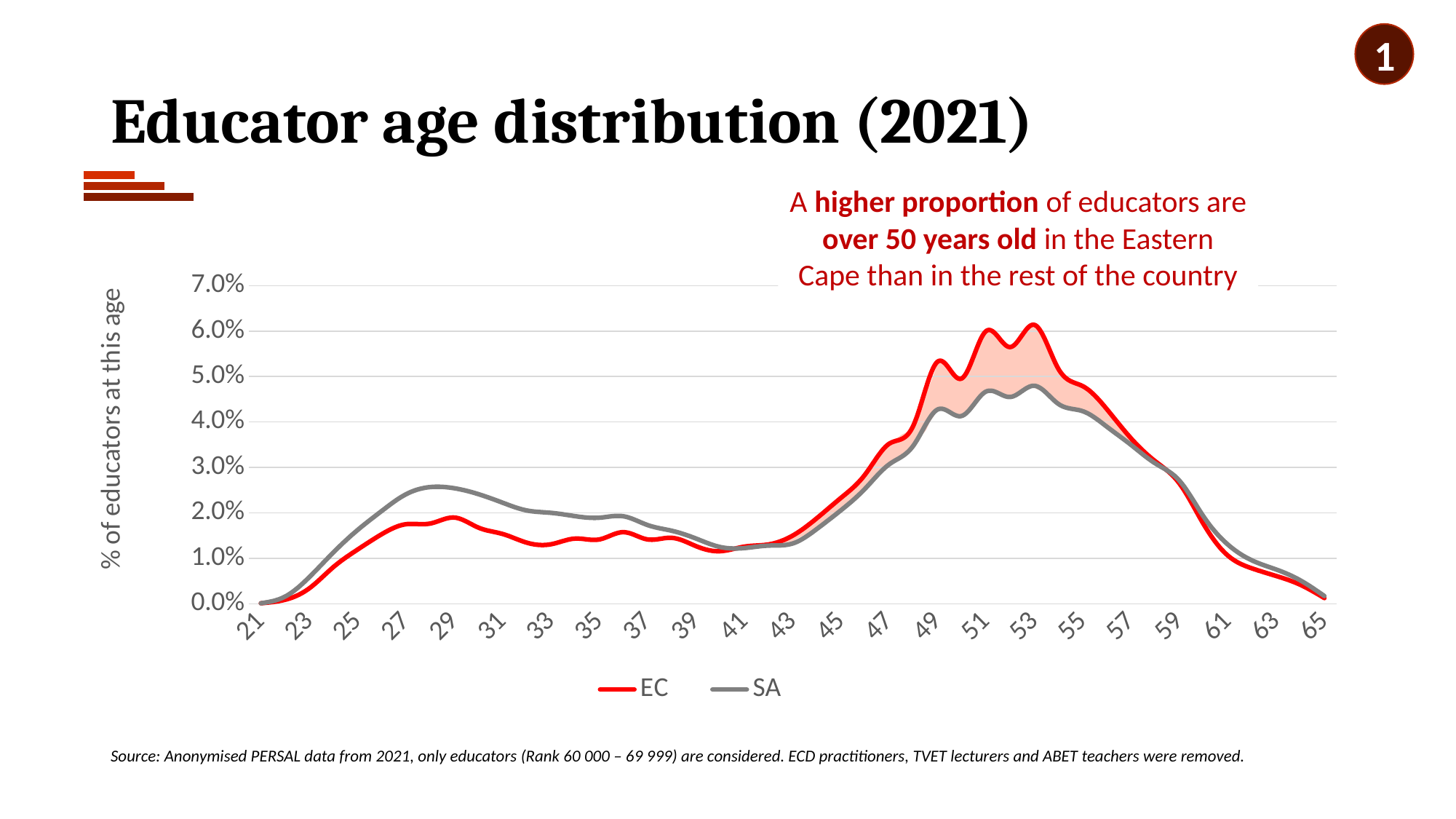
Does the EC line rise or fall between age 43 and age 53? rise At age 29, which series has the higher value, EC or SA? SA What are the two series named in the legend? EC and SA What is the label on the vertical axis? % of educators at this age Is the EC value at age 65 greater or less than 1.0%? less Is the EC value at age 41 greater or less than 2.0%? less Is the EC value at age 53 greater or less than 5.0%? greater At age 51, which series has the higher value, EC or SA? EC What kind of chart is shown on the slide? line chart How many series does the legend list? 2